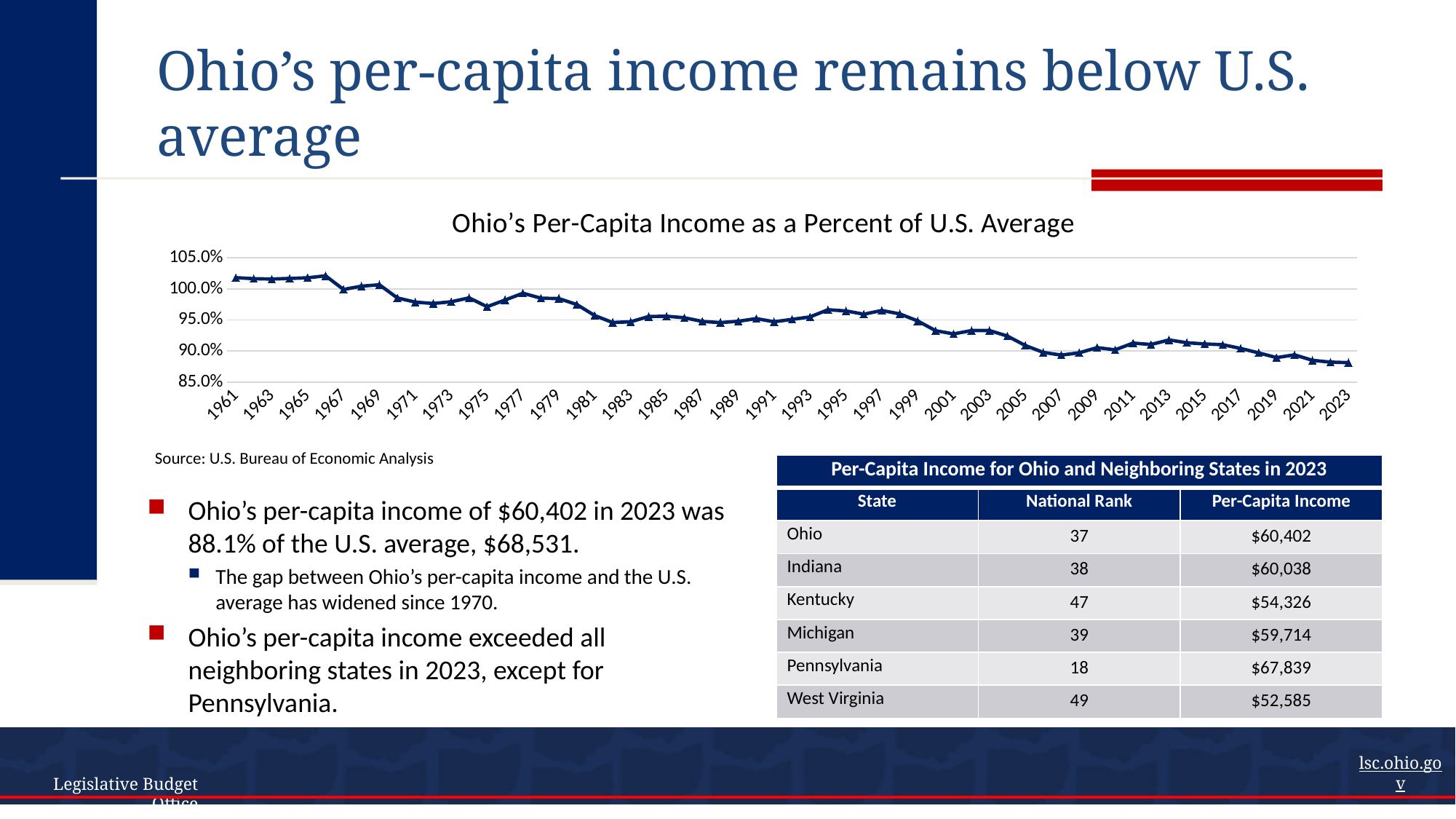
Is the value for 2013 greater or less than 90.0%? greater What was Ohio's per-capita income as a percent of the U.S. average in 2023? 88.1% Is the value for 1977 greater or less than 100.0%? less What is the source cited below the chart? U.S. Bureau of Economic Analysis What is the title of the chart? Ohio's Per-Capita Income as a Percent of U.S. Average Which is larger, the value for 1995 or the value for 2007? 1995 What kind of chart is shown on the slide? line chart Overall, do the values in the chart rise or fall from 1961 to 2023? fall Is the value for 2023 greater or less than 90.0%? less